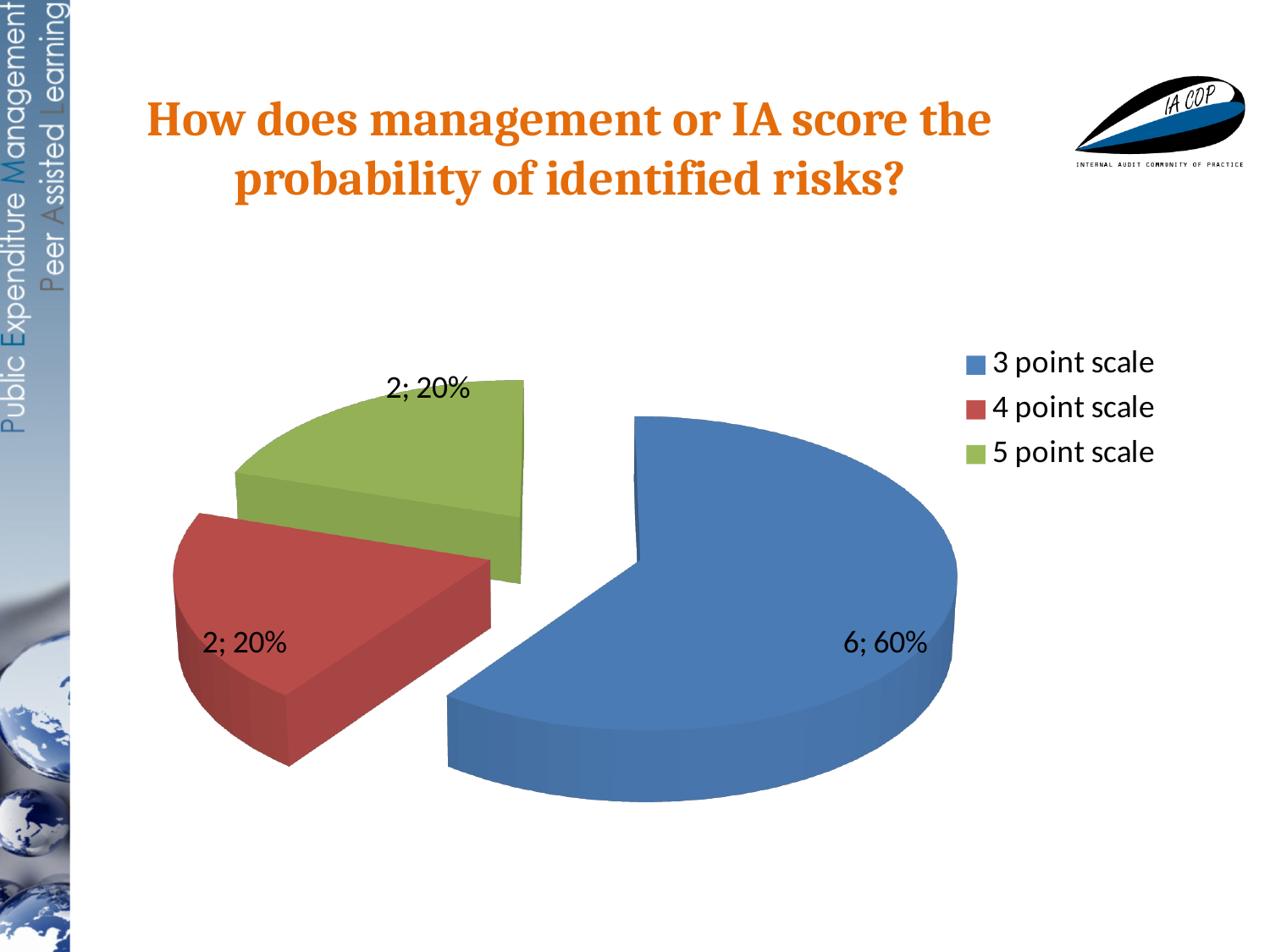
What is the count for the 4 point scale slice? 2 How many slices does the pie chart have? 3 What percentage share does the 5 point scale slice have? 20% What is the count for the 3 point scale slice? 6 What kind of chart is shown on the slide? pie chart What percentage share does the 3 point scale slice have? 60% Which is larger, the 3 point scale slice or the 5 point scale slice? 3 point scale Which scale has the largest slice of the pie? 3 point scale What is the difference in count between the 3 point scale and the 4 point scale slices? 4 What is the total count across all slices of the pie? 10 How many entries does the legend list? 3 What colour is the 4 point scale slice? red